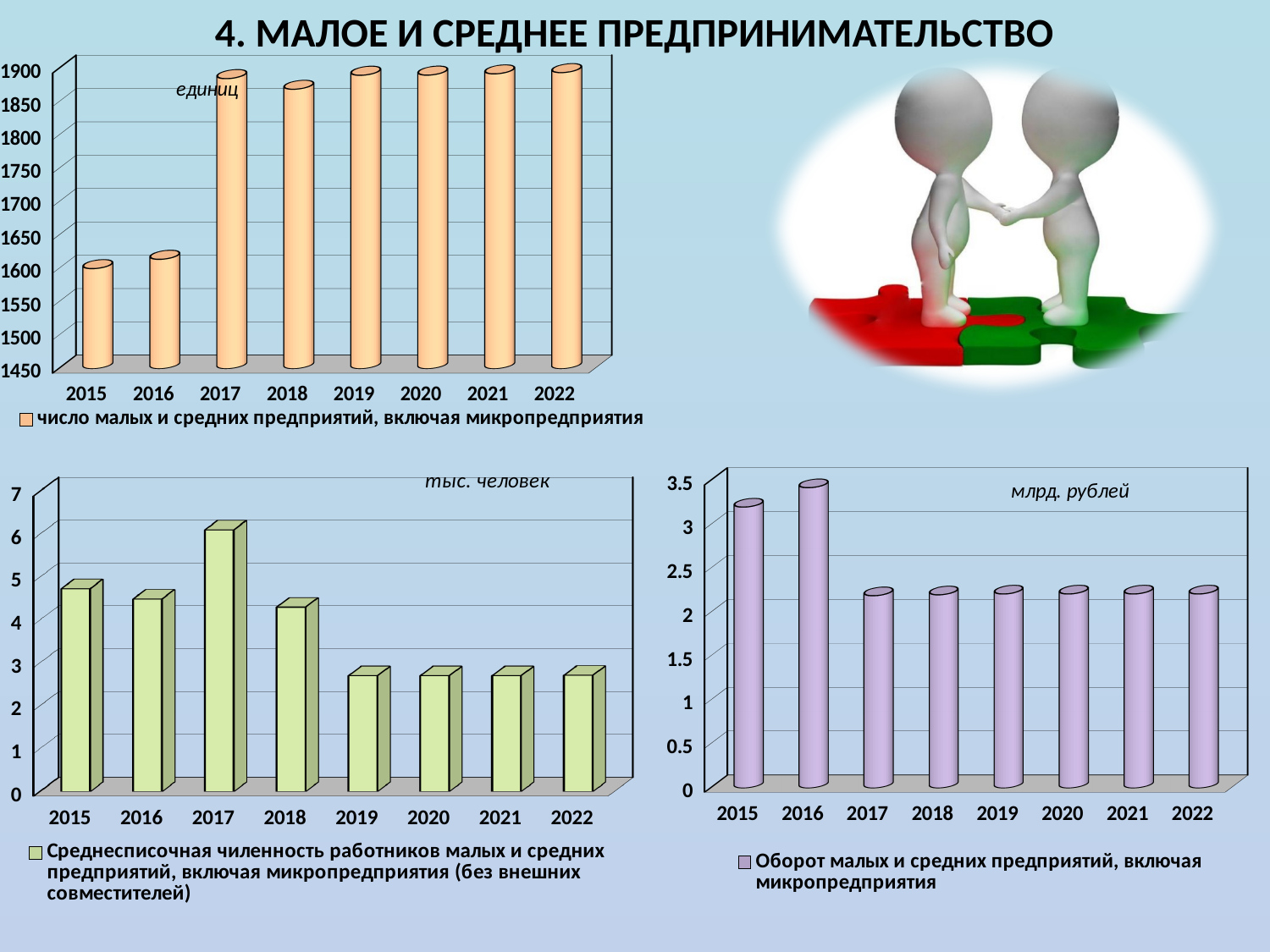
How many series does the legend of the bottom-right chart (Оборот малых и средних предприятий) list? 1 In the bottom-left chart (Среднесписочная численность работников), is the value for 2019 greater or less than 3? less In the bottom-left chart (Среднесписочная численность работников), which year has the larger value, 2018 or 2019? 2018 What type of chart is the bottom-left chart (Среднесписочная численность работников)? bar chart In the bottom-left chart (Среднесписочная численность работников), which year has the highest value? 2017 In the bottom-right chart (Оборот малых и средних предприятий), is the value for 2017 greater or less than 2.5? less What unit is indicated on the top chart (число малых и средних предприятий)? единиц How many years are shown on the x axis of the top chart (число малых и средних предприятий)? 8 In the top chart (число малых и средних предприятий), is the value for 2015 greater or less than 1650? less In the bottom-right chart (Оборот малых и средних предприятий), which year has the highest value? 2016 In the top chart (число малых и средних предприятий), which year has the larger value, 2016 or 2017? 2017